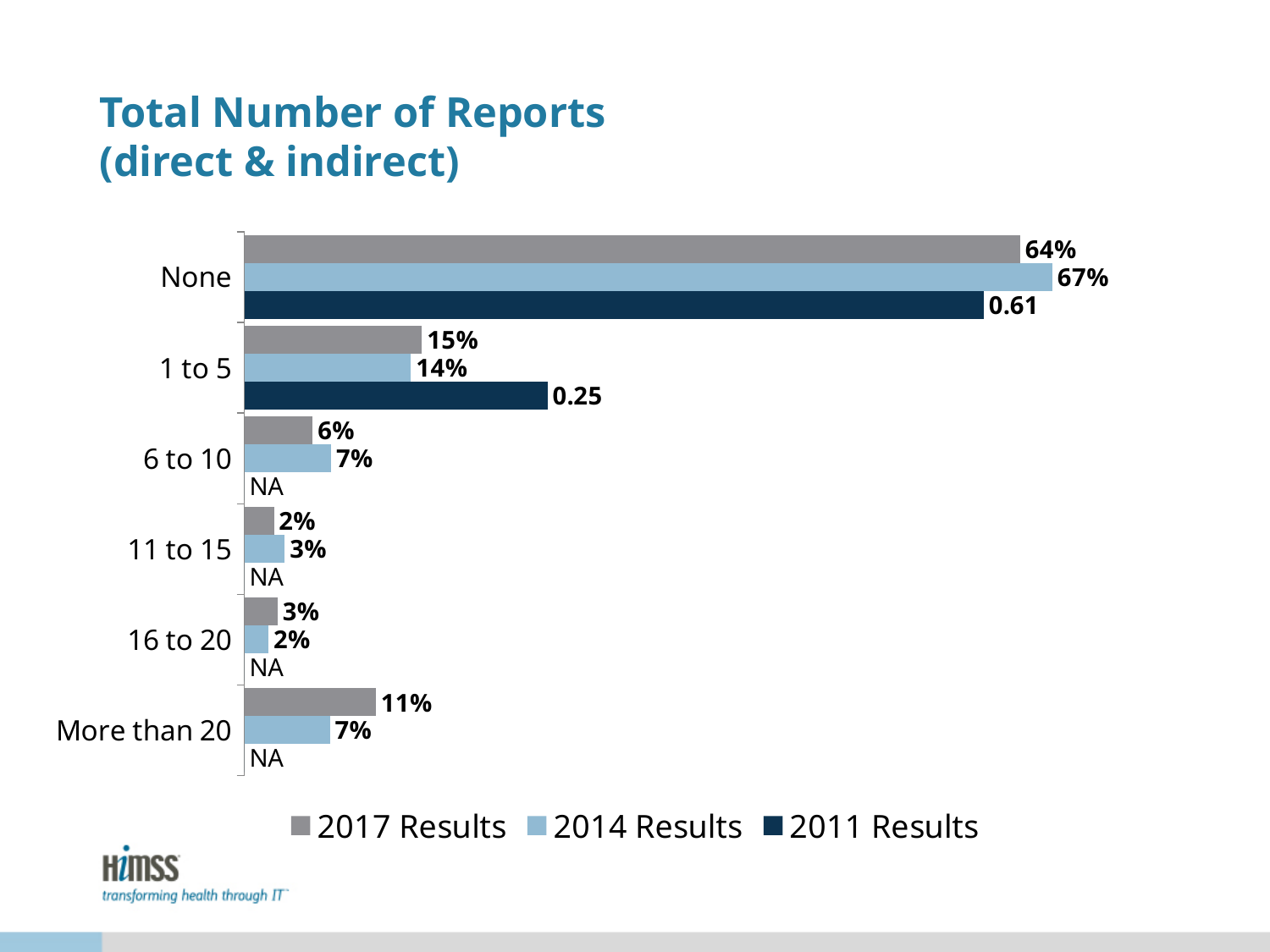
What type of chart is shown on the slide? Bar chart Which category has the lowest 2017 Results value? 11 to 15 For "More than 20" reports, which is larger: the 2017 Results value or the 2014 Results value? 2017 Results What is the 2011 Results value shown for the "None" category? 0.61 What is the difference between the 2014 and 2017 Results values for the "None" category? 3% How many series does the legend list? 3 What label is shown for the 2011 Results in the "6 to 10", "11 to 15", "16 to 20" and "More than 20" categories? NA How many categories are shown on the y axis of the chart? 6 What is the 2017 Results value for the "None" category? 64% What is the 2017 Results value for "More than 20" reports? 11% Which category has the highest 2014 Results value? None What is the 2014 Results value for "1 to 5" reports? 14%